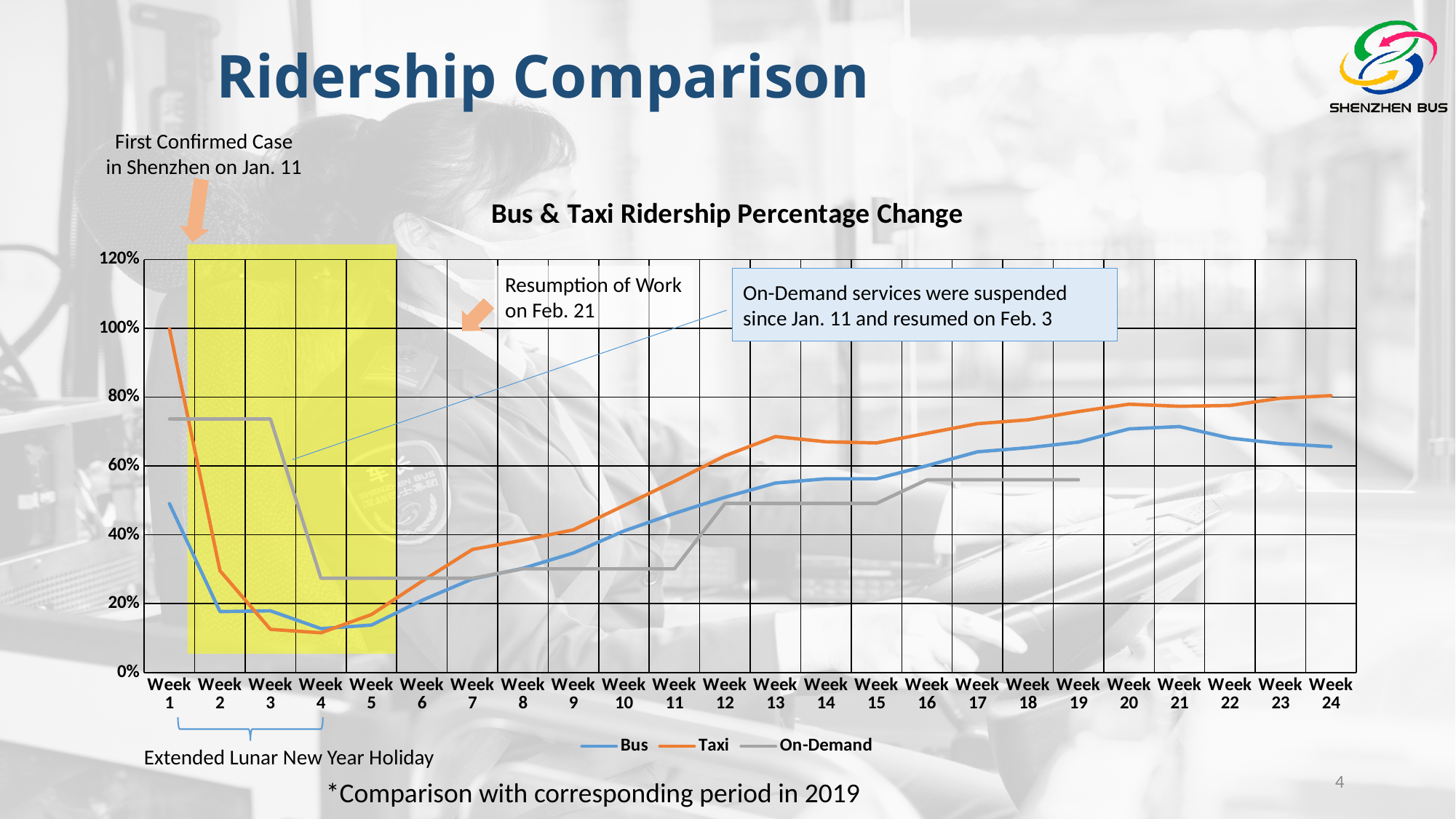
How many series does the chart legend list? 3 How many weeks are plotted along the x axis? 24 In which week is the Taxi value highest? Week 1 Does the Taxi line rise or fall from Week 1 to Week 4? Fall Does the Bus line rise or fall from Week 5 to Week 17? Rise At Week 24, which series has the higher value, Bus or Taxi? Taxi Is the Bus value at Week 1 greater or less than 60%? less Is the On-Demand value at Week 1 greater or less than 60%? greater What is the title of the chart? Bus & Taxi Ridership Percentage Change Is the Taxi value at Week 4 greater or less than 20%? less What kind of chart is shown on the slide? Line chart